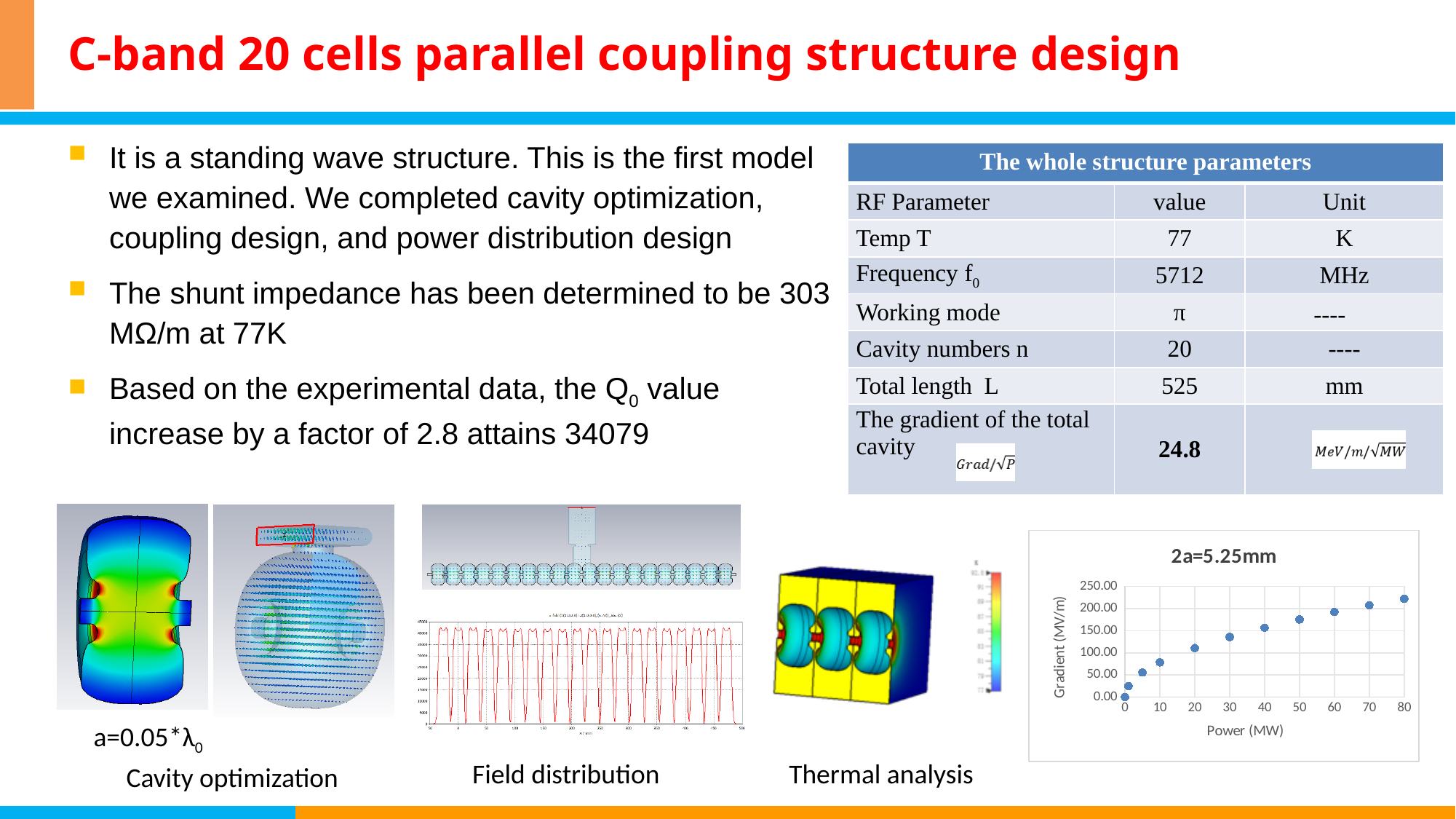
In the chart titled 2a=5.25mm, is the gradient at 30 MW greater or less than 150.00? less In the chart titled 2a=5.25mm, at which power value is the gradient highest? 80 How many data points are plotted in the chart titled 2a=5.25mm? 11 In the chart titled 2a=5.25mm, is the gradient at 50 MW greater or less than 150.00? greater What kind of chart is shown at the bottom right of the slide? scatter chart What is the title of the chart at the bottom right of the slide? 2a=5.25mm In the chart titled 2a=5.25mm, which has the larger gradient: 20 MW or 60 MW? 60 MW In the chart titled 2a=5.25mm, is the gradient at 10 MW greater or less than 100.00? less In the chart titled 2a=5.25mm, does the gradient rise or fall as power increases? rises In the chart titled 2a=5.25mm, at which power value is the gradient lowest? 0 In the chart titled 2a=5.25mm, what is the label of the x axis? Power (MW)